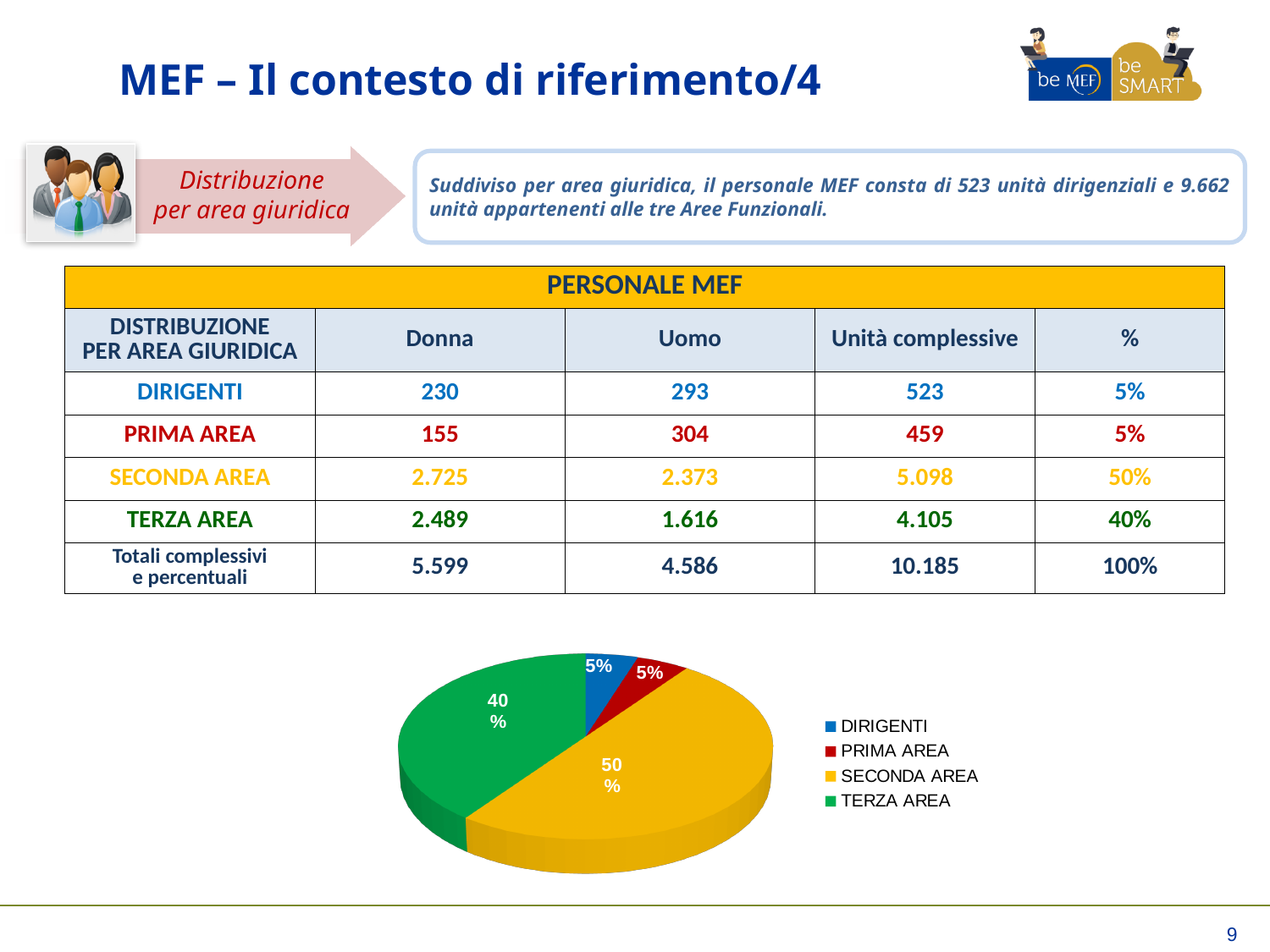
What share of the pie chart does DIRIGENTI represent? 5% Which slice is larger in the pie chart, TERZA AREA or DIRIGENTI? TERZA AREA What share of the pie chart does PRIMA AREA represent? 5% What share of the pie chart does SECONDA AREA represent? 50% How many entries does the legend of the pie chart list? 4 How many slices does the pie chart have? 4 What colour is the SECONDA AREA slice in the pie chart? Yellow What share of the pie chart does TERZA AREA represent? 40% Which category has the largest slice in the pie chart? SECONDA AREA By how many percentage points does the SECONDA AREA slice exceed the TERZA AREA slice in the pie chart? 10 percentage points What type of chart is shown on the slide? Pie chart Which slice is larger in the pie chart, SECONDA AREA or TERZA AREA? SECONDA AREA